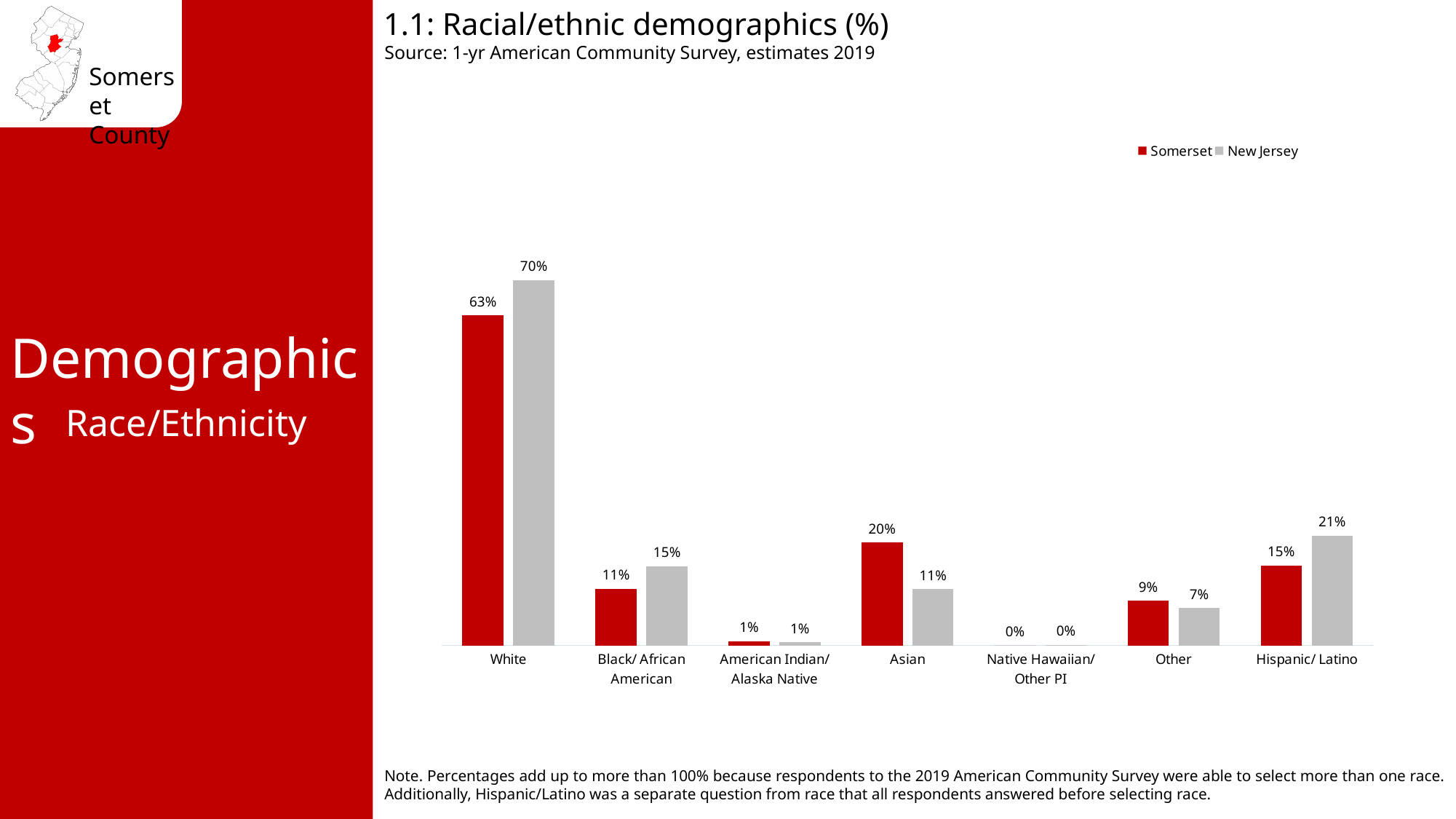
How many categories are shown on the x axis? 7 Which is larger for Asian, the Somerset value or the New Jersey value? Somerset Which category has the highest Somerset value? White What is the New Jersey value for Black/ African American? 15% What is the Somerset value for White? 63% What is the New Jersey value for Hispanic/ Latino? 21% How many series does the legend list? 2 What kind of chart is shown? Bar chart What is the Somerset value for Asian? 20% What is the difference between the New Jersey and Somerset values for White? 7% What is the source given under the chart title? 1-yr American Community Survey, estimates 2019 Which category has the lowest New Jersey value? Native Hawaiian/ Other PI